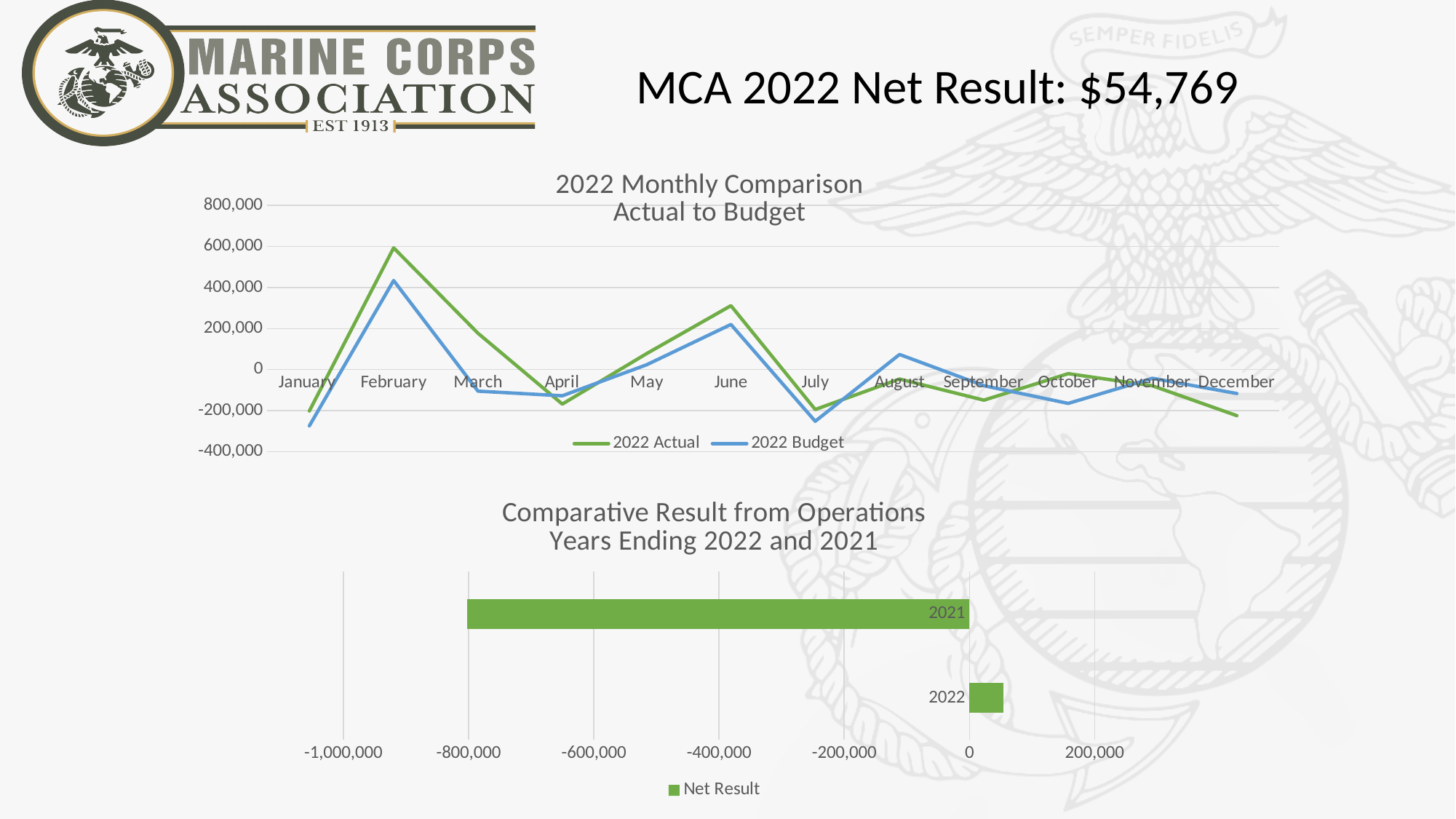
In the '2022 Monthly Comparison Actual to Budget' chart, which is larger in August: 2022 Actual or 2022 Budget? 2022 Budget What kind of chart is the '2022 Monthly Comparison Actual to Budget' chart? Line chart In the 'Comparative Result from Operations' chart, which year has the lower Net Result? 2021 What kind of chart is the 'Comparative Result from Operations Years Ending 2022 and 2021' chart? Bar chart In the 'Comparative Result from Operations' chart, how many series does the legend list? 1 In the '2022 Monthly Comparison Actual to Budget' chart, what are the two legend entries? 2022 Actual and 2022 Budget In the '2022 Monthly Comparison Actual to Budget' chart, how many months are plotted along the x axis? 12 In the '2022 Monthly Comparison Actual to Budget' chart, is the 2022 Actual value for February greater or less than 400,000? greater In the '2022 Monthly Comparison Actual to Budget' chart, which is larger in February: 2022 Actual or 2022 Budget? 2022 Actual In the '2022 Monthly Comparison Actual to Budget' chart, which month has the highest 2022 Actual value? February In the '2022 Monthly Comparison Actual to Budget' chart, how many series does the legend list? 2 In the 'Comparative Result from Operations' chart, is the Net Result for 2021 greater or less than -600,000? less